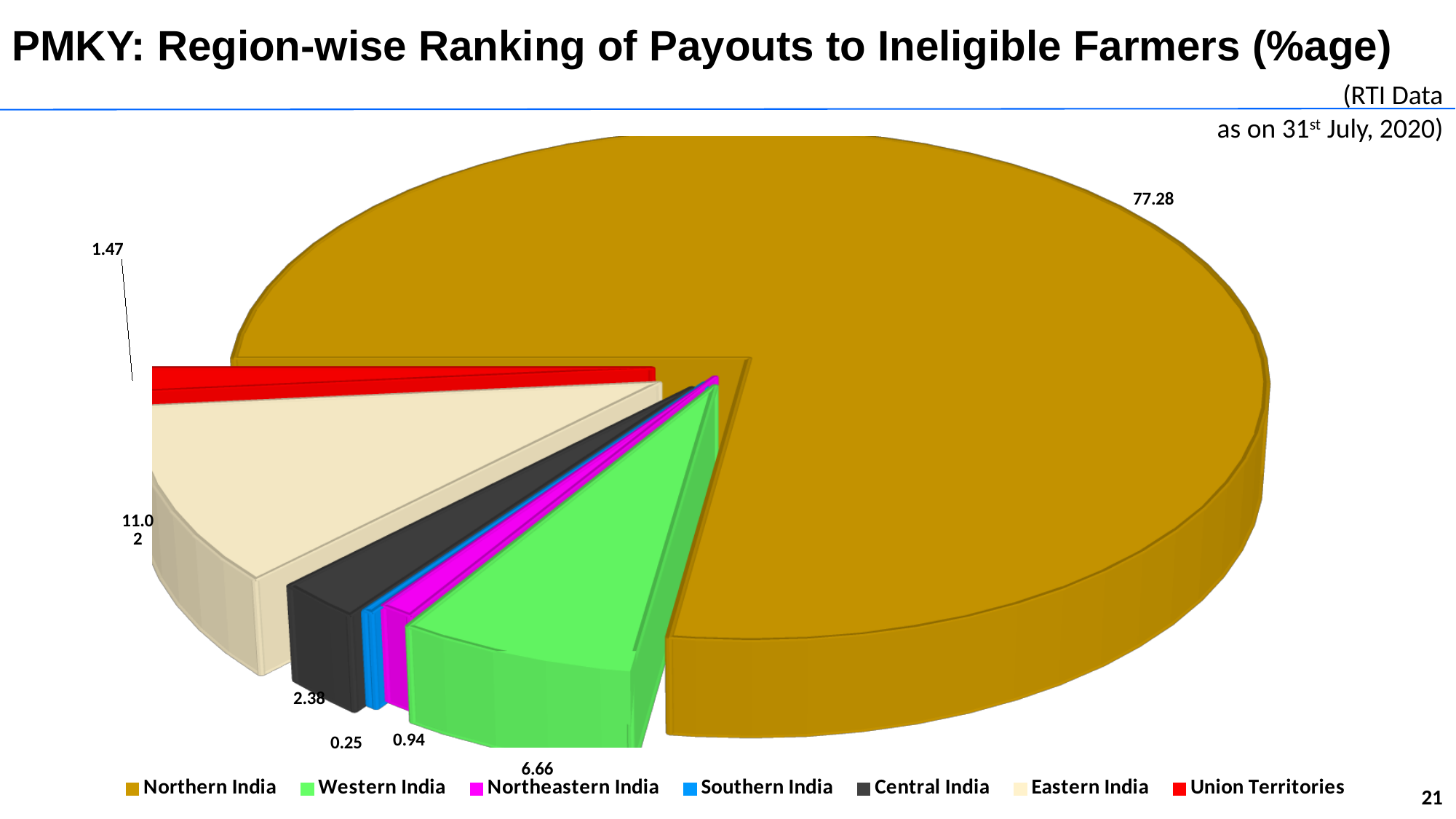
Which region has the smallest share of the pie? Southern India What is the value for Southern India? 0.25 What is the value for Western India? 6.66 What is the difference between the values for Eastern India and Western India? 4.36 What is the value for Union Territories? 1.47 Which is larger, the value for Central India or the value for Northeastern India? Central India What kind of chart is shown on the slide? pie chart What is the value for Northern India? 77.28 How many regions does the legend list? 7 Which region has the largest share of the pie? Northern India What is the value for Eastern India? 11.02 What is the value for Central India? 2.38